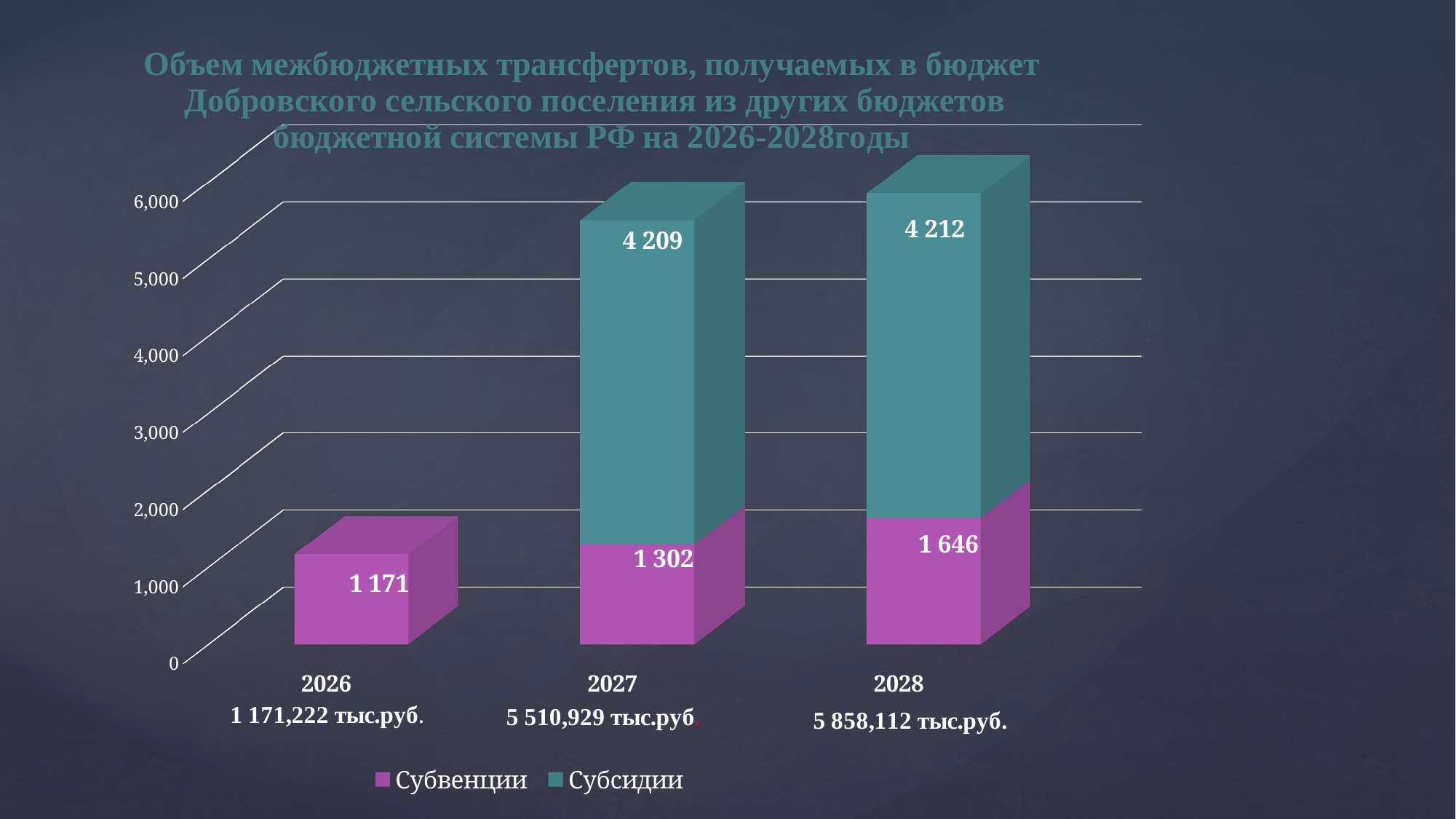
What is the value of Субсидии for 2027? 4 209 How many years are shown on the x axis? 3 What is the difference between the Субвенции values for 2028 and 2027? 344 How many series does the legend list? 2 Do the Субвенции values rise or fall from 2026 to 2028? Rise What is the value of Субвенции for 2028? 1 646 What kind of chart is shown on the slide? Stacked bar chart Which year has the lowest value for Субвенции? 2026 What is the value of Субсидии for 2028? 4 212 What is the value of Субвенции for 2026? 1 171 Which year has the highest value for Субвенции? 2028 For 2028, which is larger: Субсидии or Субвенции? Субсидии